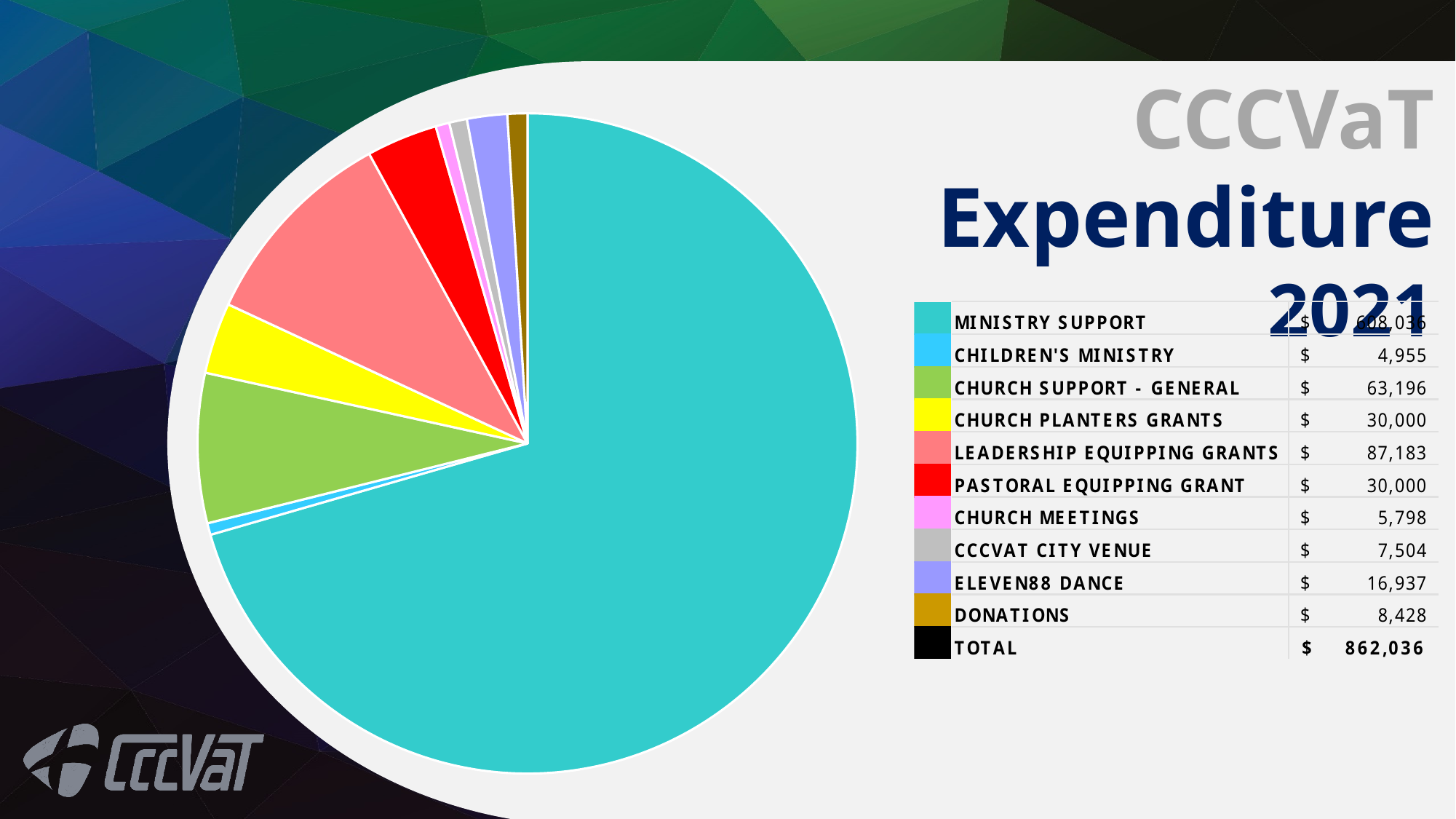
What type of chart is shown on the slide? Pie chart What is the value for Eleven88 Dance? $ 16,937 What colour represents Church Planters Grants in the pie chart? Yellow What is the value for Donations? $ 8,428 Which category has the largest slice of the pie? Ministry Support Which is larger, Eleven88 Dance or CCCVaT City Venue? Eleven88 Dance Which category has the smallest value in the table? Children's Ministry How many expenditure categories are listed in the legend, excluding the total? 10 What is the value for Leadership Equipping Grants? $ 87,183 What is the total expenditure shown in the table? $ 862,036 What is the difference between Leadership Equipping Grants and Church Support - General? 23,987 What is the value for Church Support - General? $ 63,196